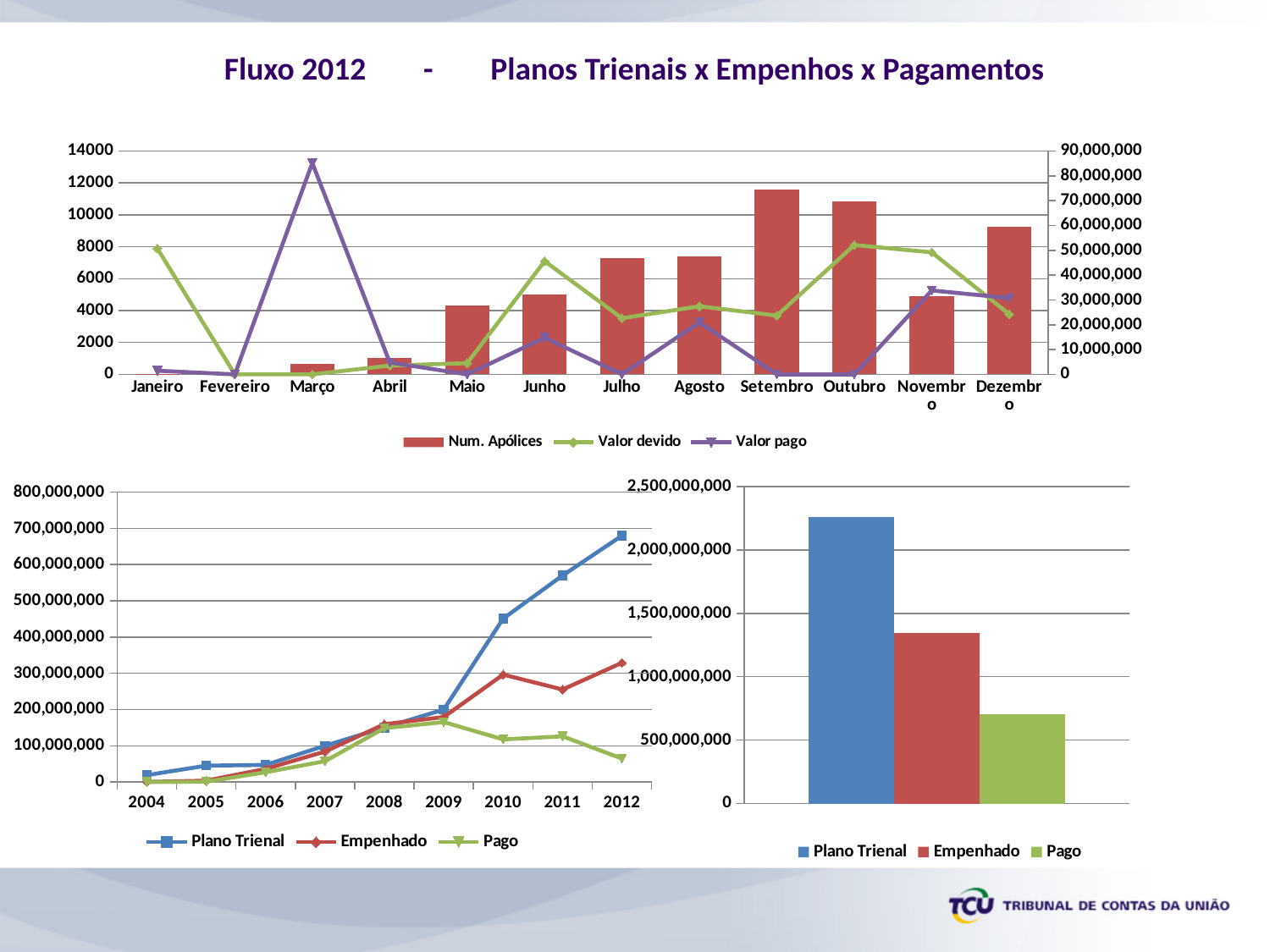
In the bottom-left line chart, is the Pago value for 2012 greater or less than 100,000,000? less In the top chart (Fluxo 2012), which month has the highest Num. Apólices bar? Setembro In the top chart (Fluxo 2012), is the Num. Apólices value for Julho greater or less than 8000? less In the top chart (Fluxo 2012), how many months are shown on the x axis? 12 In the top chart (Fluxo 2012), how many series does the legend list? 3 In the bottom-left line chart, how many years are shown on the x axis? 9 In the bottom-left line chart, is the Plano Trienal value for 2012 greater or less than 600,000,000? greater In the bottom-left line chart, does the Plano Trienal series rise or fall from 2004 to 2012? rise In the bottom-right chart, which series has the tallest bar? Plano Trienal In the top chart (Fluxo 2012), in which month does the Valor pago line reach its highest point? Março